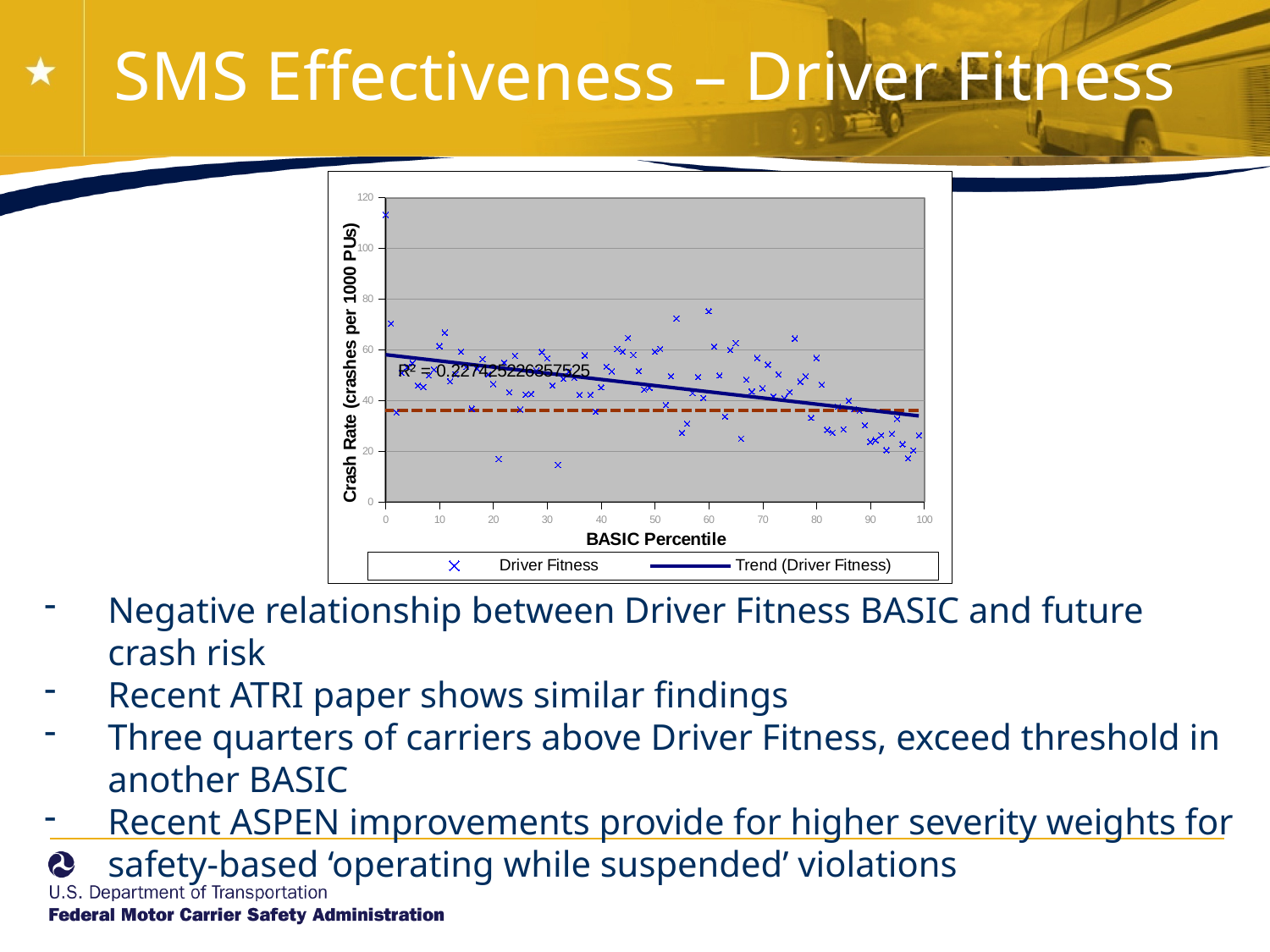
Is the value of the trend line at BASIC Percentile 100 greater or less than 40? Less Does the trend line for Driver Fitness rise or fall as BASIC Percentile increases? Falls Which end of the BASIC Percentile axis does the trend line show a higher crash rate at, 0 or 100? 0 Is the value of the trend line at BASIC Percentile 0 greater or less than 40? Greater What is the name of the second legend entry in the chart? Trend (Driver Fitness) Is the crash rate of the highest plotted Driver Fitness point greater or less than 100? Greater What kind of chart is shown on the slide? Scatter chart How many entries does the chart legend list? 2 What is the title of the x axis of the chart? BASIC Percentile